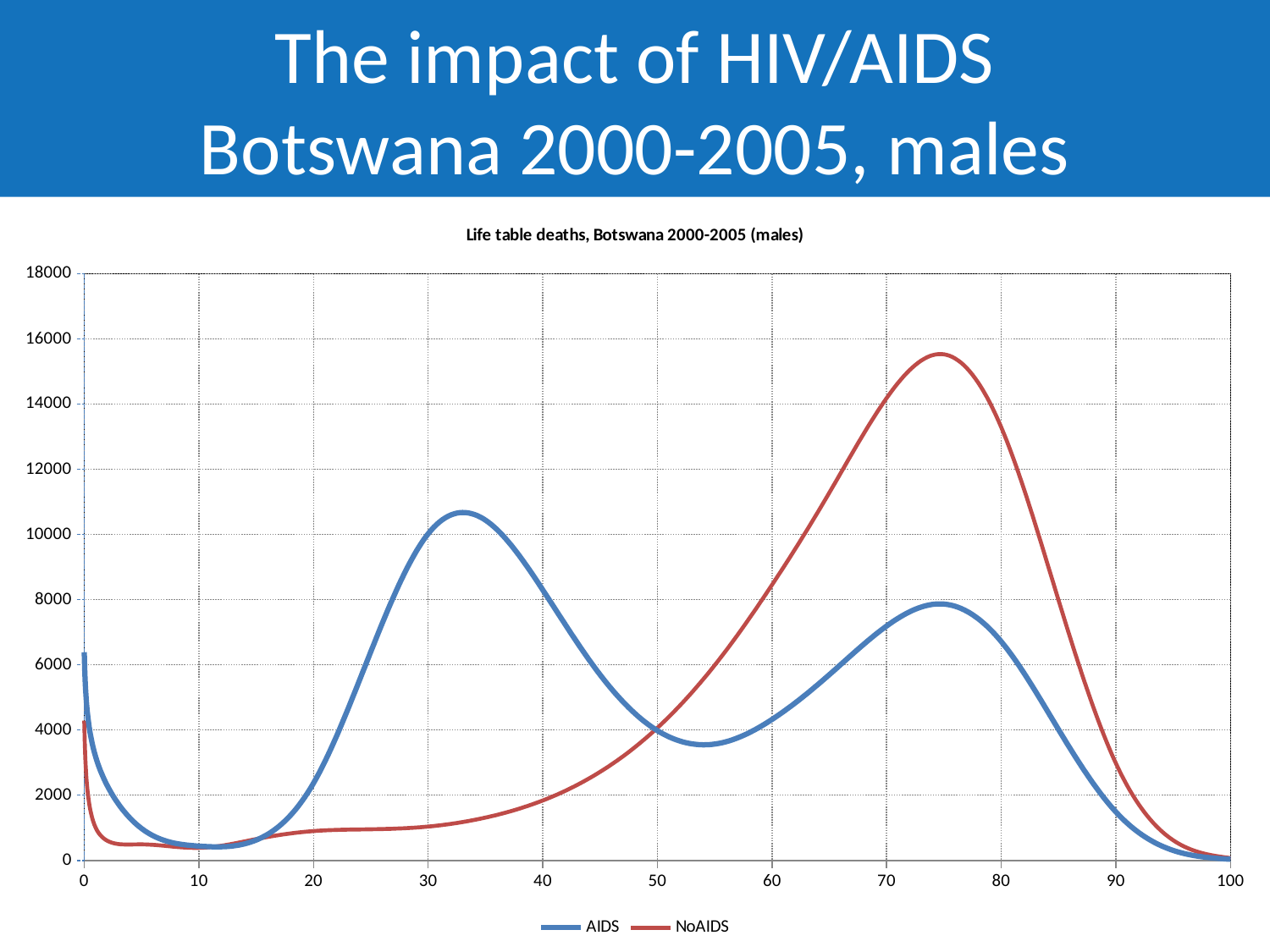
Is the value for the AIDS series at age 55 greater or less than 6000? less At age 30, which series has the higher value, AIDS or NoAIDS? AIDS What kind of chart is shown on the slide? line chart What colour is the AIDS series line? blue At age 70, which series has the higher value, AIDS or NoAIDS? NoAIDS Is the value for the NoAIDS series at age 30 greater or less than 2000? less Does the NoAIDS series rise or fall between age 80 and age 100? fall How many series does the legend list? 2 Which series reaches the higher peak value overall? NoAIDS What is the title of the chart? Life table deaths, Botswana 2000-2005 (males) Is the value for the AIDS series at age 30 greater or less than 8000? greater